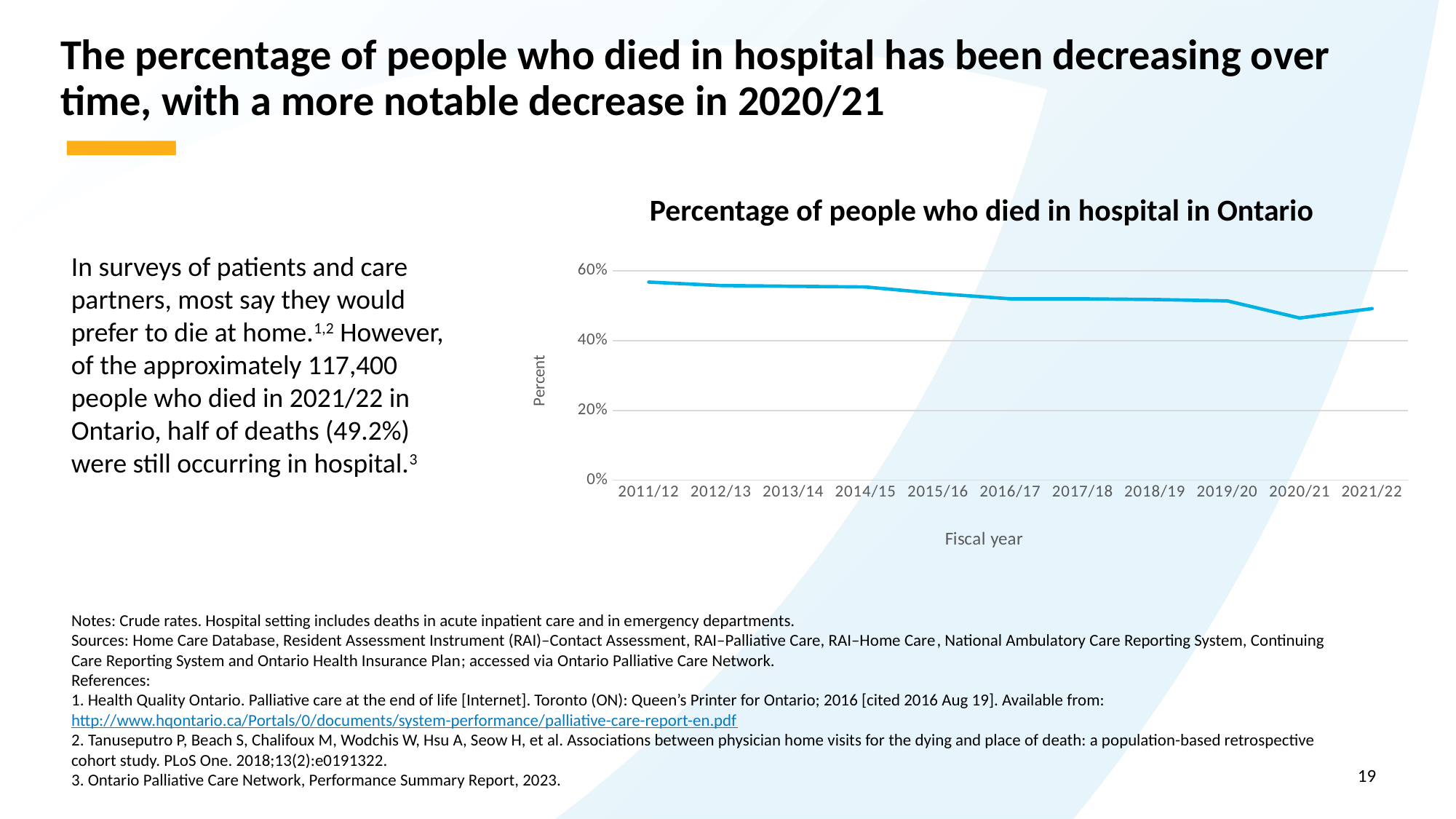
Which is larger, the value for 2011/12 or the value for 2021/22? 2011/12 Which is larger, the value for 2019/20 or the value for 2020/21? 2019/20 Is the value for 2011/12 greater or less than 40%? greater Which fiscal year has the lowest percentage of people who died in hospital? 2020/21 Does the percentage of people who died in hospital generally rise or fall from 2011/12 to 2020/21? fall What kind of chart is shown on the slide? line chart What is the label of the x axis of the chart? Fiscal year Is the value for 2020/21 greater or less than 40%? greater What is the title of the chart? Percentage of people who died in hospital in Ontario Is the value for 2011/12 greater or less than 60%? less How many fiscal years are plotted on the x axis of the chart? 11